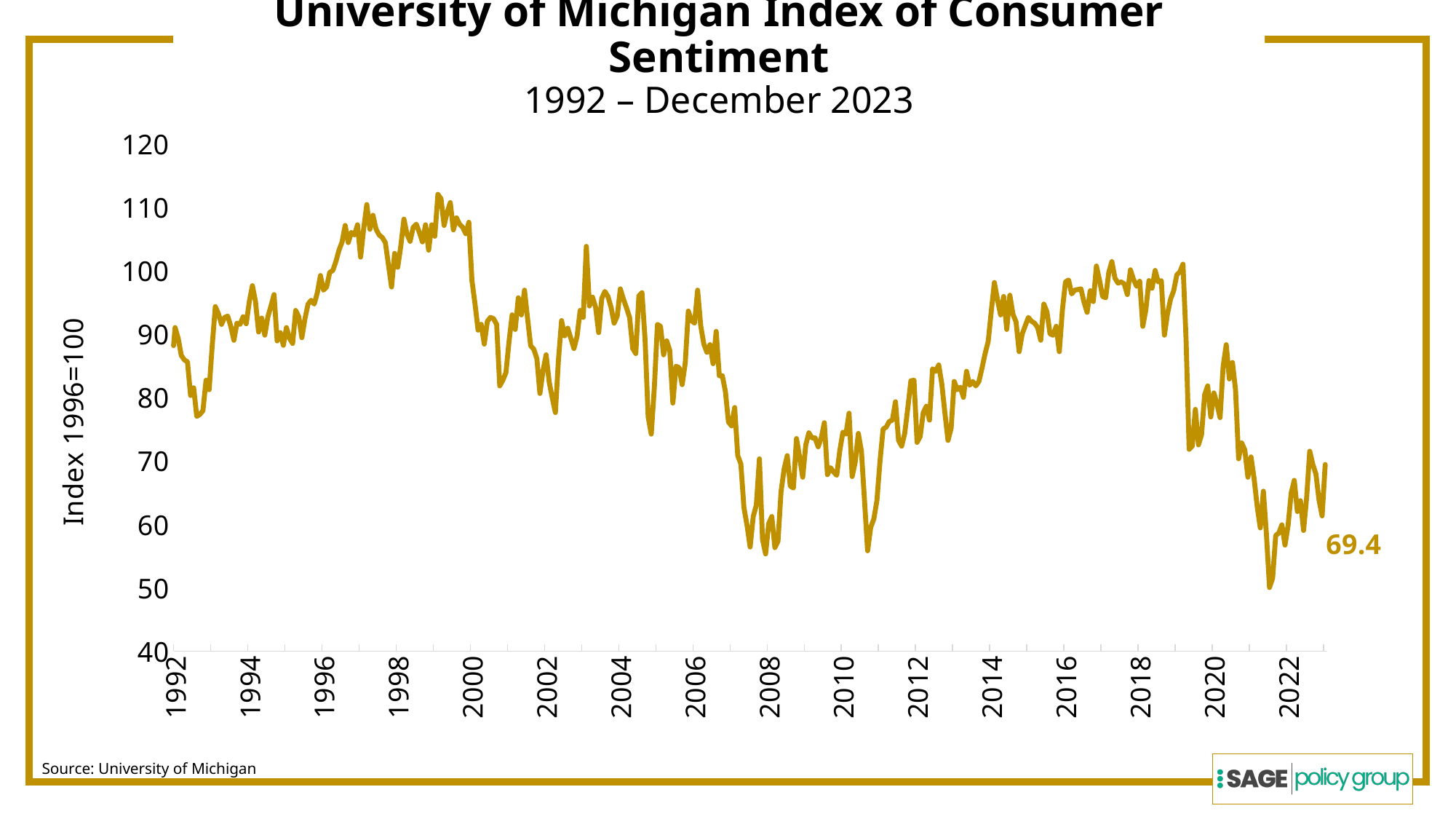
Is the final labelled value of the index greater or less than 70? less What source is cited for the chart? University of Michigan What kind of chart is shown on the slide? line chart Which is higher, the index around 1999 or the index around 2008? 1999 What is the value of the index labelled at the end of the series (December 2023)? 69.4 Is the peak value of the index around 1999 greater or less than 100? greater In which year does the index reach its lowest point on the chart? 2022 Is the lowest value of the index around 2008 greater or less than 60? less Does the index generally rise or fall between 2018 and 2022? fall Does the index generally rise or fall between 2008 and 2014? rise What is the label on the vertical axis? Index 1996=100